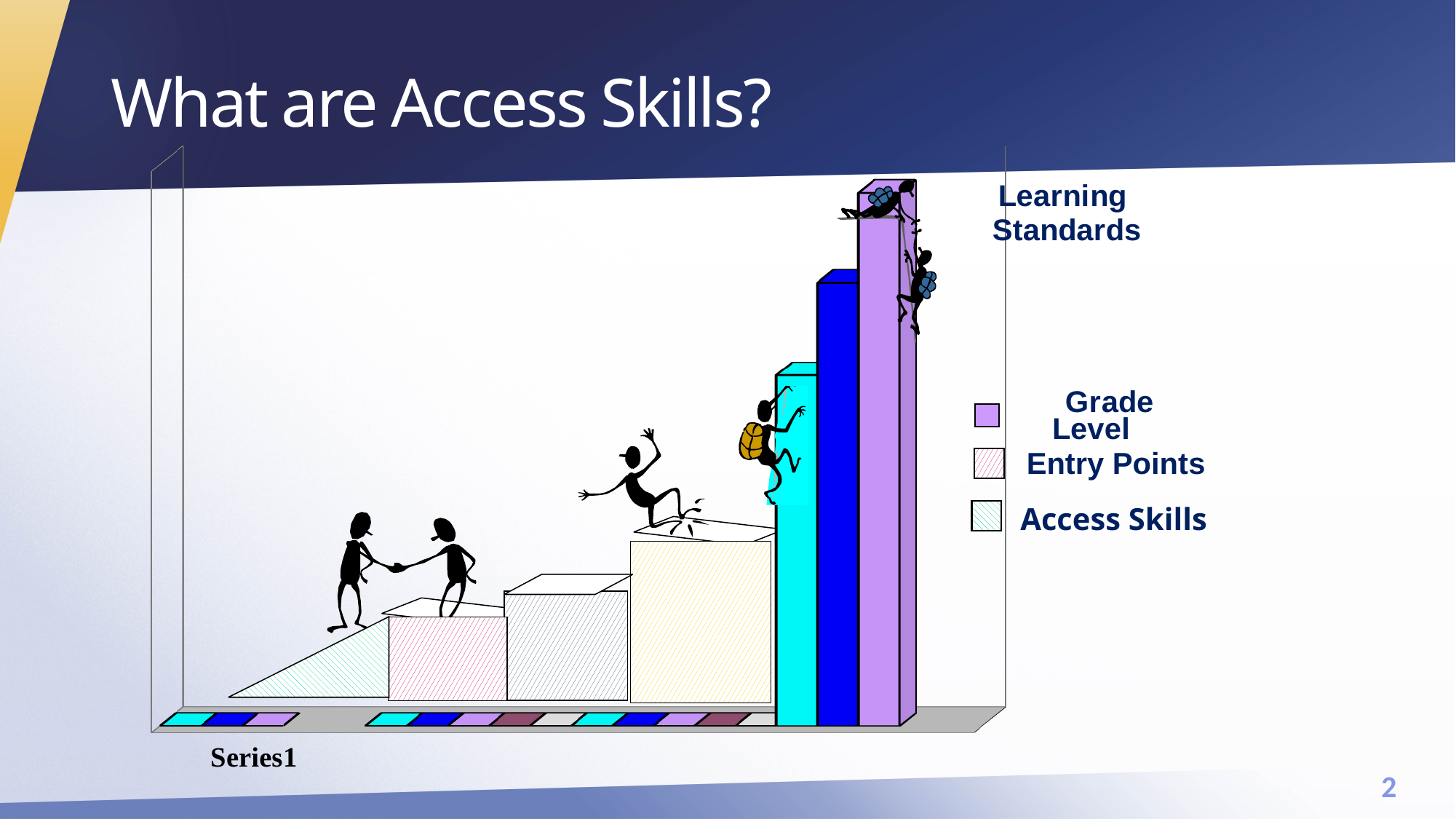
Which is taller, the purple bar or the cyan bar? the purple bar Which legend entry corresponds to the tallest bar in the chart? Grade Level What kind of chart is shown on the slide? bar chart What label is written at the top right of the chart, above the legend? Learning Standards Do the bar heights rise or fall from left to right across the chart? rise What label appears on the x axis of the chart? Series1 How many entries does the chart's legend list? 3 Which is taller, the blue bar or the yellow hatched bar? the blue bar Which legend entry corresponds to the shortest shape in the chart? Access Skills What are the three entries in the chart's legend? Grade Level, Entry Points, Access Skills